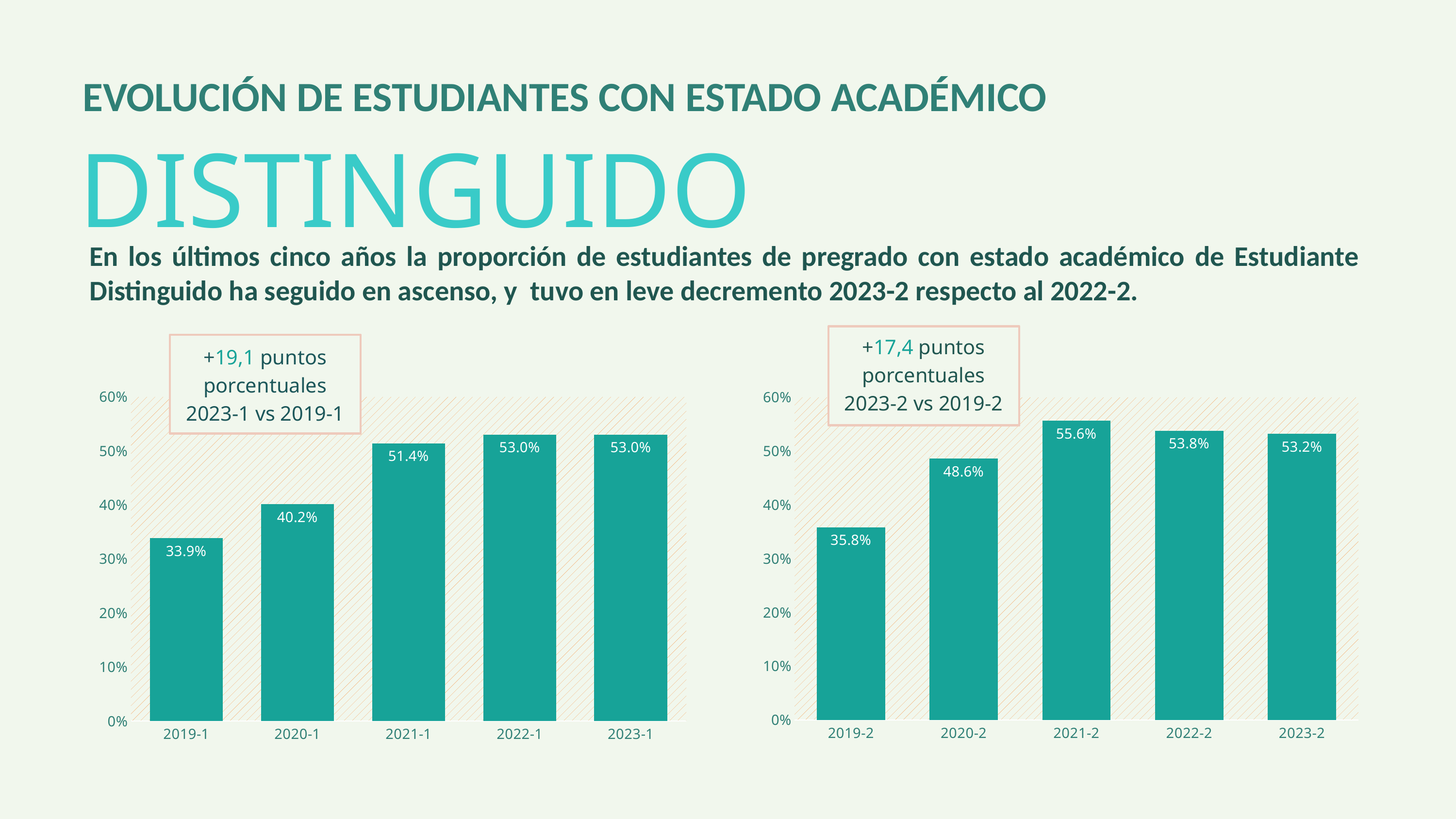
In the right chart (2019-2 to 2023-2), what is the value for 2020-2? 48.6% According to the annotation box on the left chart, by how many percentage points did the value change from 2019-1 to 2023-1? +19,1 puntos porcentuales In the right chart (2019-2 to 2023-2), which period has the highest value? 2021-2 In the right chart (2019-2 to 2023-2), which is larger, the value for 2019-2 or the value for 2020-2? 2020-2 In the left chart (2019-1 to 2023-1), which period has the lowest value? 2019-1 In the left chart (2019-1 to 2023-1), what is the difference between the values for 2020-1 and 2019-1? 6.3 percentage points In the right chart (2019-2 to 2023-2), what is the difference between the values for 2021-2 and 2022-2? 1.8 percentage points How many periods are shown on the x axis of the left chart (2019-1 to 2023-1)? 5 In the right chart (2019-2 to 2023-2), what is the value for 2023-2? 53.2% In the left chart (2019-1 to 2023-1), what is the value for 2021-1? 51.4% In the left chart (2019-1 to 2023-1), what is the value for 2019-1? 33.9% What kind of chart is the right chart (2019-2 to 2023-2)? Bar chart